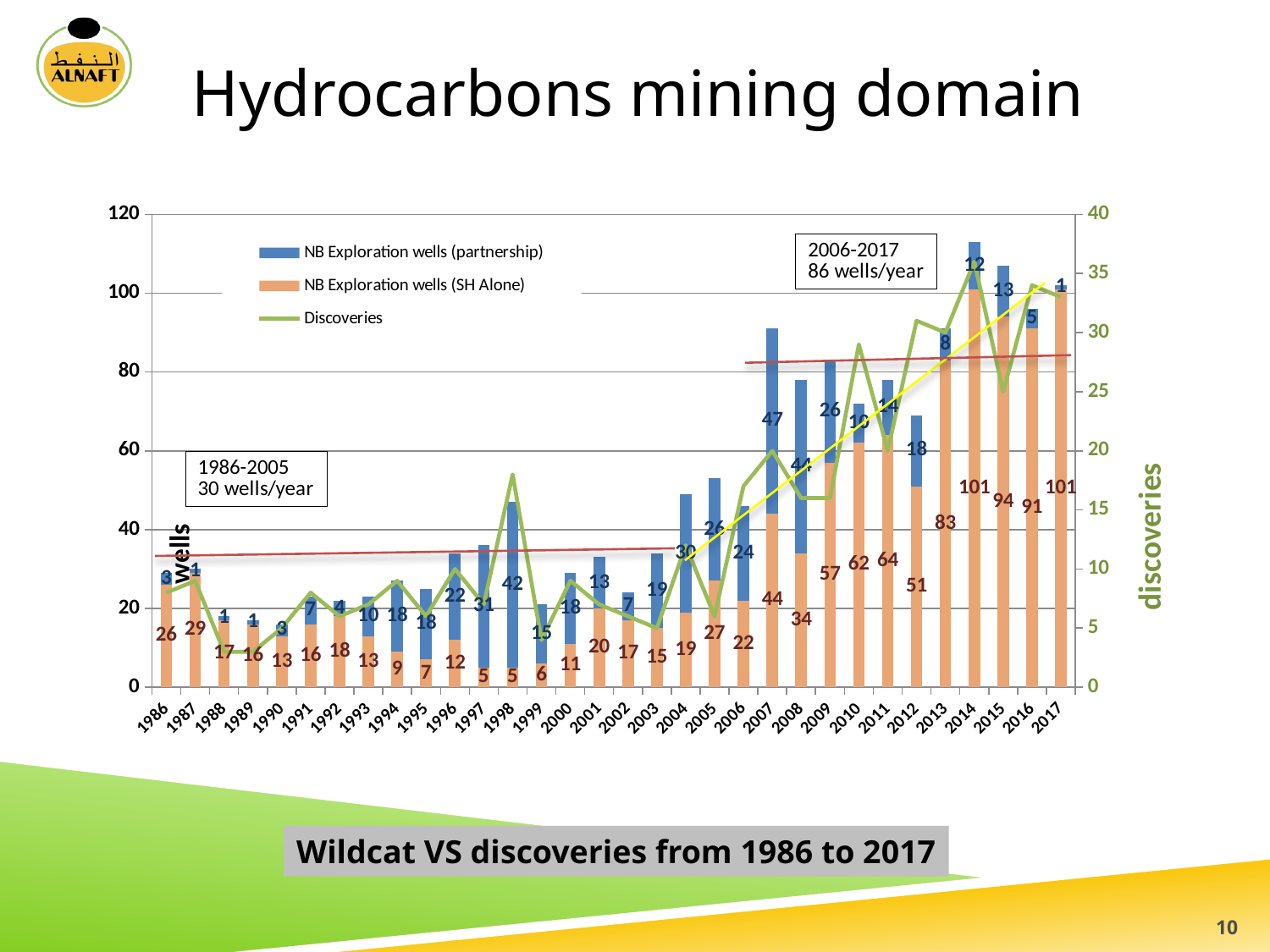
Which year has the highest value for NB Exploration wells (partnership)? 2007 According to the annotation box, what was the average number of wells per year for 2006-2017? 86 wells/year Which year has the larger NB Exploration wells (SH Alone) value, 2009 or 2010? 2010 What is the value of NB Exploration wells (SH Alone) for 2014? 101 What is the difference between the NB Exploration wells (SH Alone) values for 2013 and 2012? 32 What kind of chart is shown on the slide? Bar chart with a line How many series does the legend list? 3 What is the total height of the stacked bar for 2014 (partnership plus SH Alone)? 113 Do the NB Exploration wells (SH Alone) values generally rise or fall from 2005 to 2011? rise How many years are shown on the x axis? 32 Is the Discoveries value for 2014 greater or less than 30? greater What is the value of NB Exploration wells (partnership) for 1998? 42